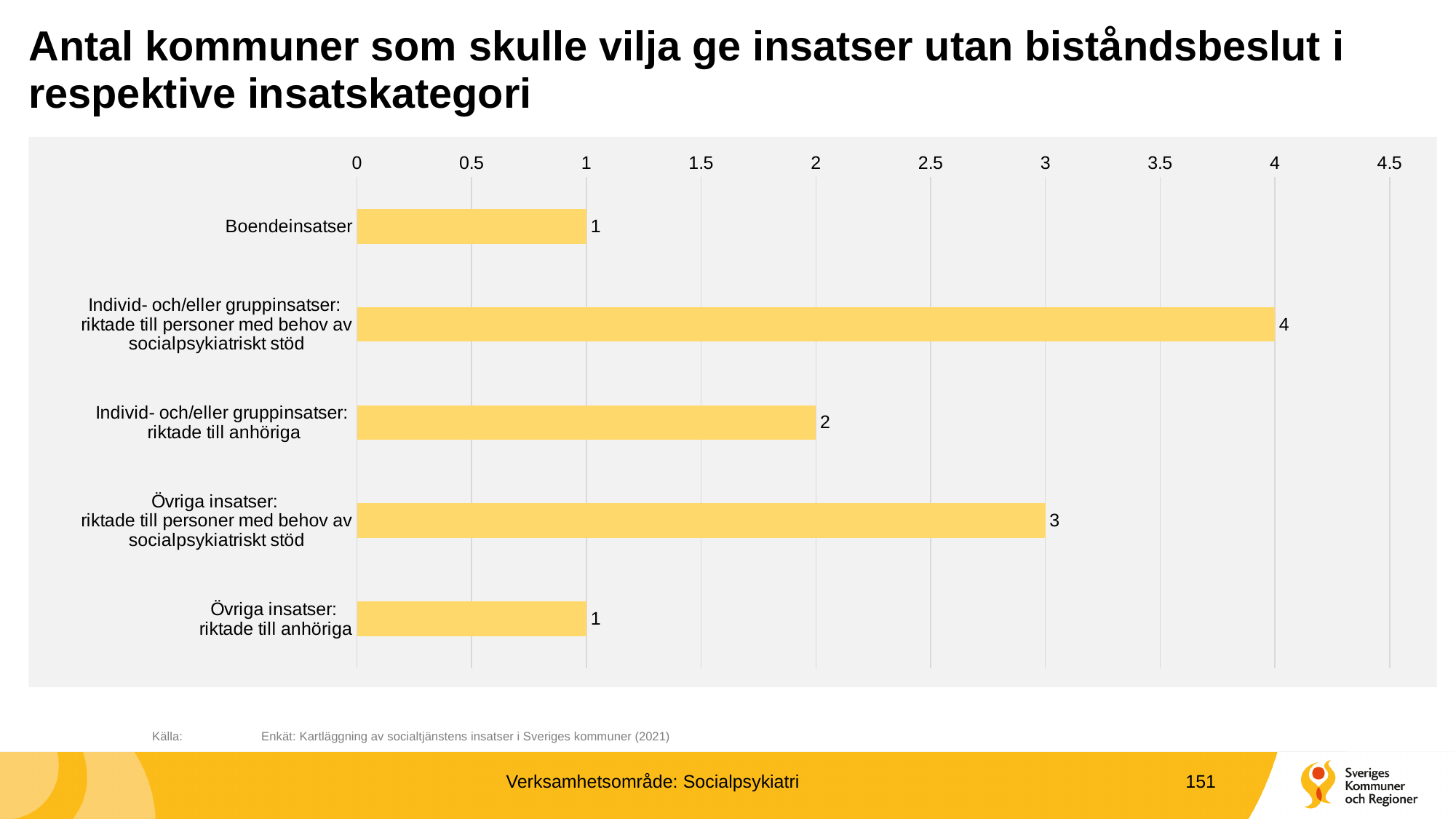
What is the difference between the values for Individ- och/eller gruppinsatser: riktade till personer med behov av socialpsykiatriskt stöd and Övriga insatser: riktade till anhöriga? 3 What is the difference between the values for Övriga insatser: riktade till personer med behov av socialpsykiatriskt stöd and Individ- och/eller gruppinsatser: riktade till anhöriga? 1 Which is larger: the value for Individ- och/eller gruppinsatser: riktade till anhöriga or the value for Övriga insatser: riktade till personer med behov av socialpsykiatriskt stöd? Övriga insatser: riktade till personer med behov av socialpsykiatriskt stöd What is the value for Boendeinsatser? 1 What is the value for Övriga insatser: riktade till personer med behov av socialpsykiatriskt stöd? 3 How many categories are shown in the chart? 5 What is the value for Individ- och/eller gruppinsatser: riktade till anhöriga? 2 What kind of chart is shown on the slide? Bar chart Is the value for Övriga insatser: riktade till personer med behov av socialpsykiatriskt stöd greater or less than 2? greater Which category has the highest value? Individ- och/eller gruppinsatser: riktade till personer med behov av socialpsykiatriskt stöd What is the value for Individ- och/eller gruppinsatser: riktade till personer med behov av socialpsykiatriskt stöd? 4 What is the highest value shown on the chart's axis? 4.5